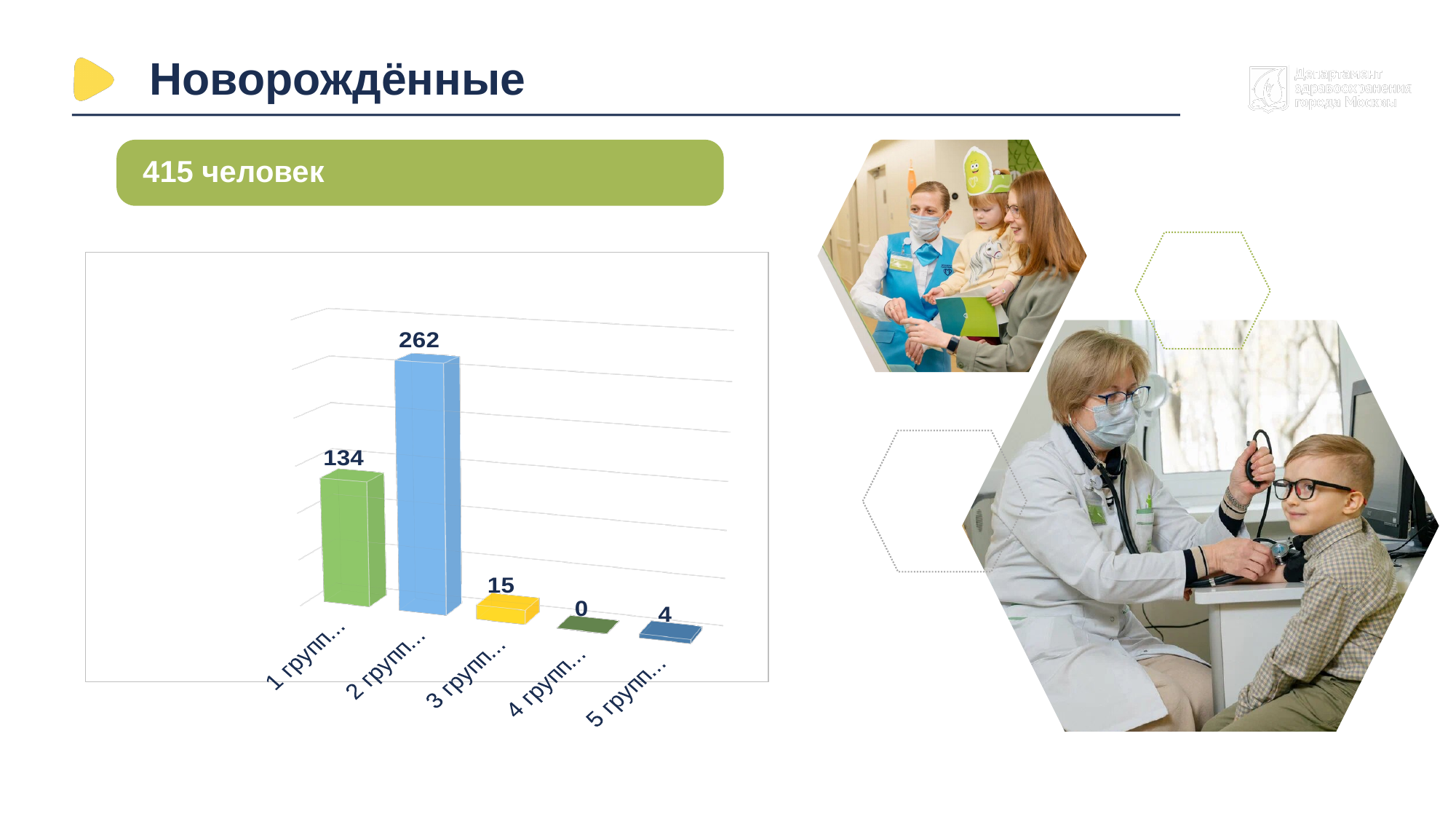
Which category has the lowest value? 4 групп… What value is shown for the bar labelled "3 групп…"? 15 What value is shown for the bar labelled "1 групп…"? 134 What is the difference between the values for "2 групп…" and "1 групп…"? 128 What value is shown for the bar labelled "5 групп…"? 4 What value is shown for the bar labelled "4 групп…"? 0 What value is shown for the bar labelled "2 групп…"? 262 Which category has the highest value? 2 групп… What kind of chart is shown on the slide? Bar chart What total number of people is stated in the green banner above the chart? 415 человек Which is larger, the value for "3 групп…" or the value for "5 групп…"? 3 групп… How many categories are shown on the chart? 5